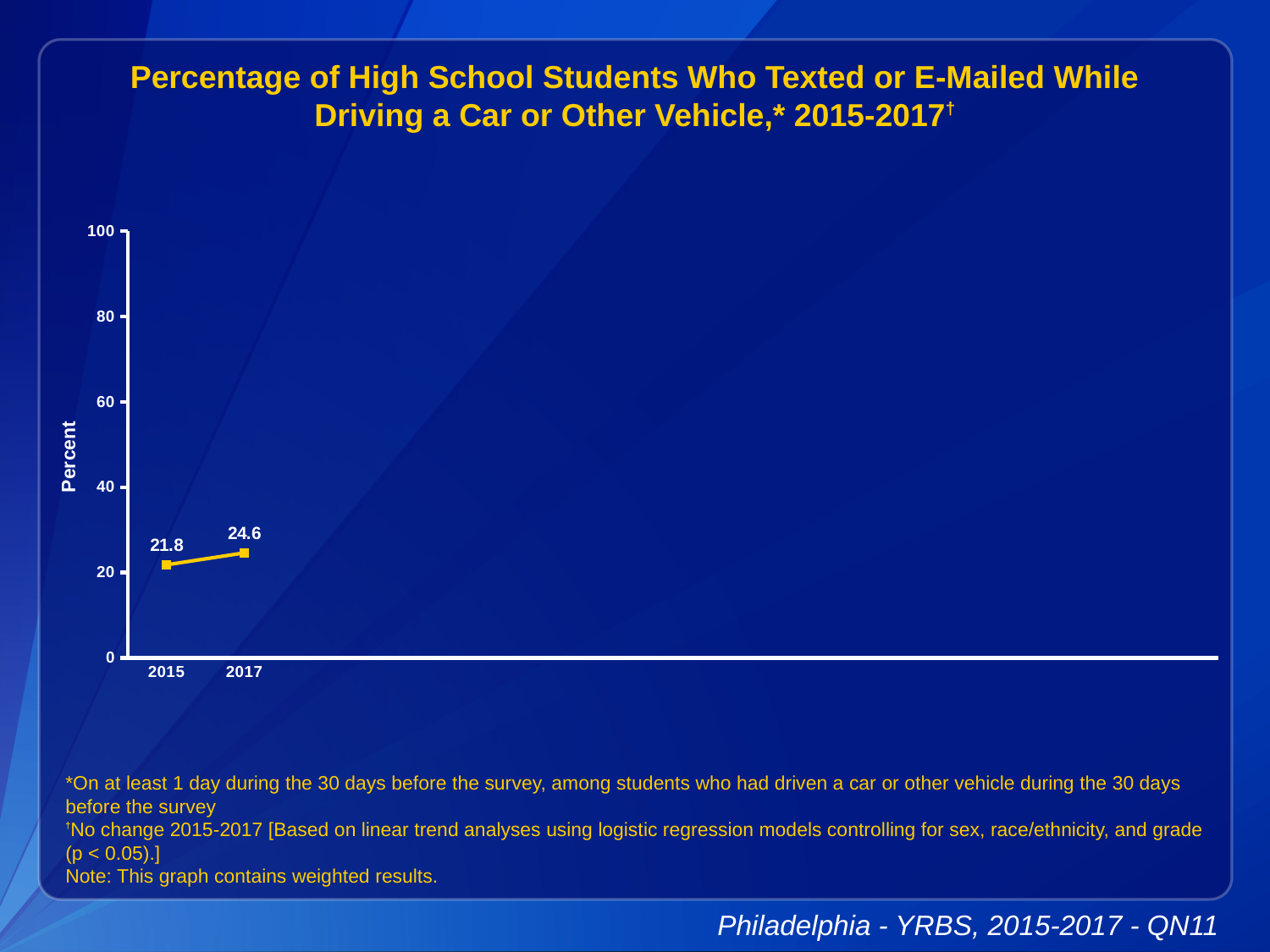
What is the difference between the 2017 and 2015 values? 2.8 Is the value for 2017 greater or less than 40? less Which year has the lowest value? 2015 Do the values rise or fall from 2015 to 2017? rise Is the value for 2015 greater or less than 20? greater Which is larger, the value for 2015 or the value for 2017? 2017 How many data points are plotted on the chart? 2 What is the value for 2015? 21.8 What is the value for 2017? 24.6 What is the label on the y axis? Percent Which year has the highest value? 2017 What kind of chart is shown on the slide? line chart